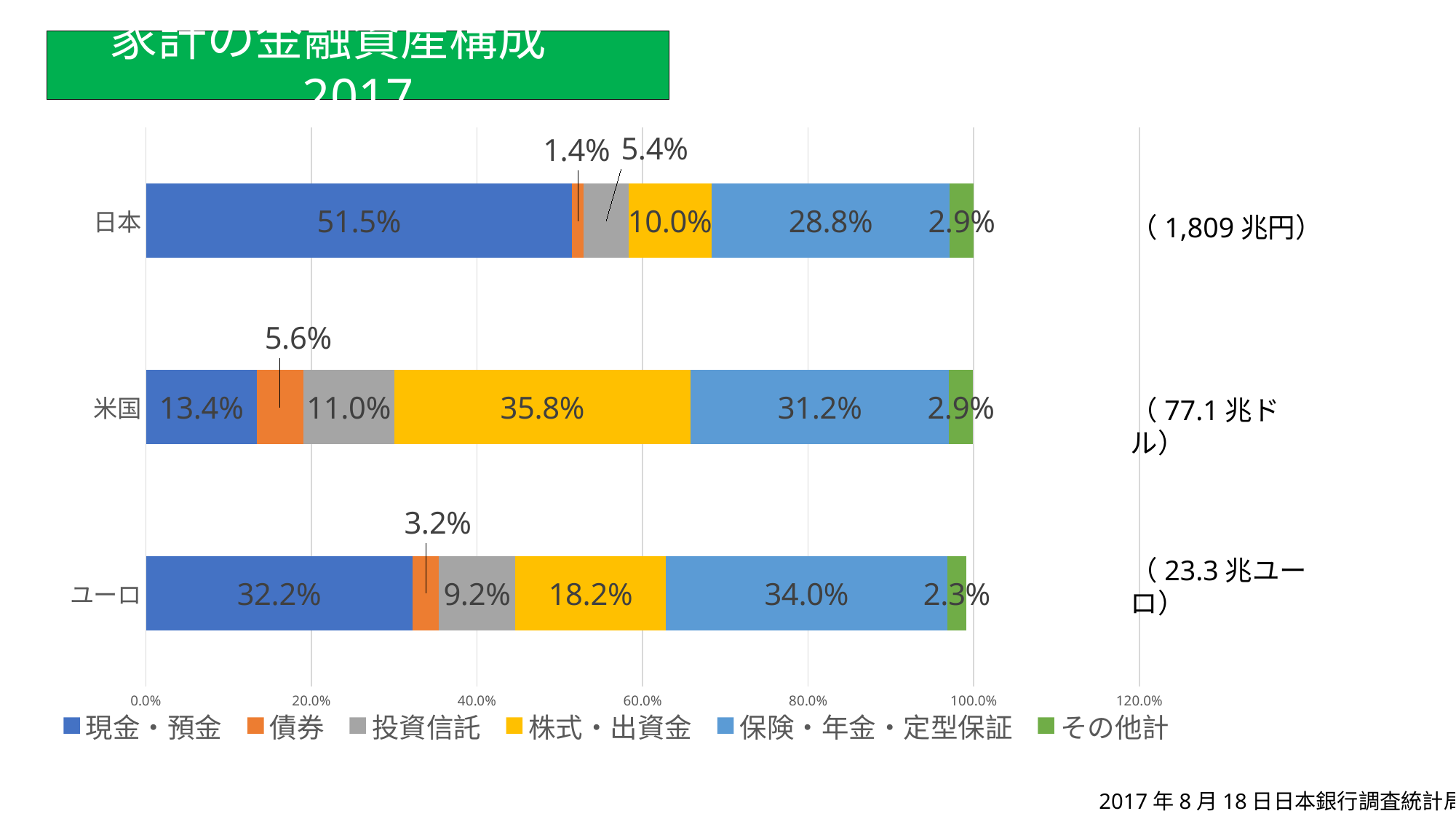
Which is larger: the 投資信託 share of 米国 or of ユーロ? 米国 Which region has the lowest share of 株式・出資金? 日本 How many series does the legend list? 6 What is the value of 株式・出資金 for 米国? 35.8% Which region has the highest share of 現金・預金? 日本 What is the value of 現金・預金 for 日本? 51.5% What is the value of 債券 for 日本? 1.4% What is the value of 保険・年金・定型保証 for ユーロ? 34.0% What is the difference between the 株式・出資金 share of 米国 and that of ユーロ? 17.6% How many categories (regions) are plotted on the chart? 3 What is the total financial asset amount shown next to the 日本 bar? 1,809 兆円 What kind of chart is shown on the slide? stacked bar chart